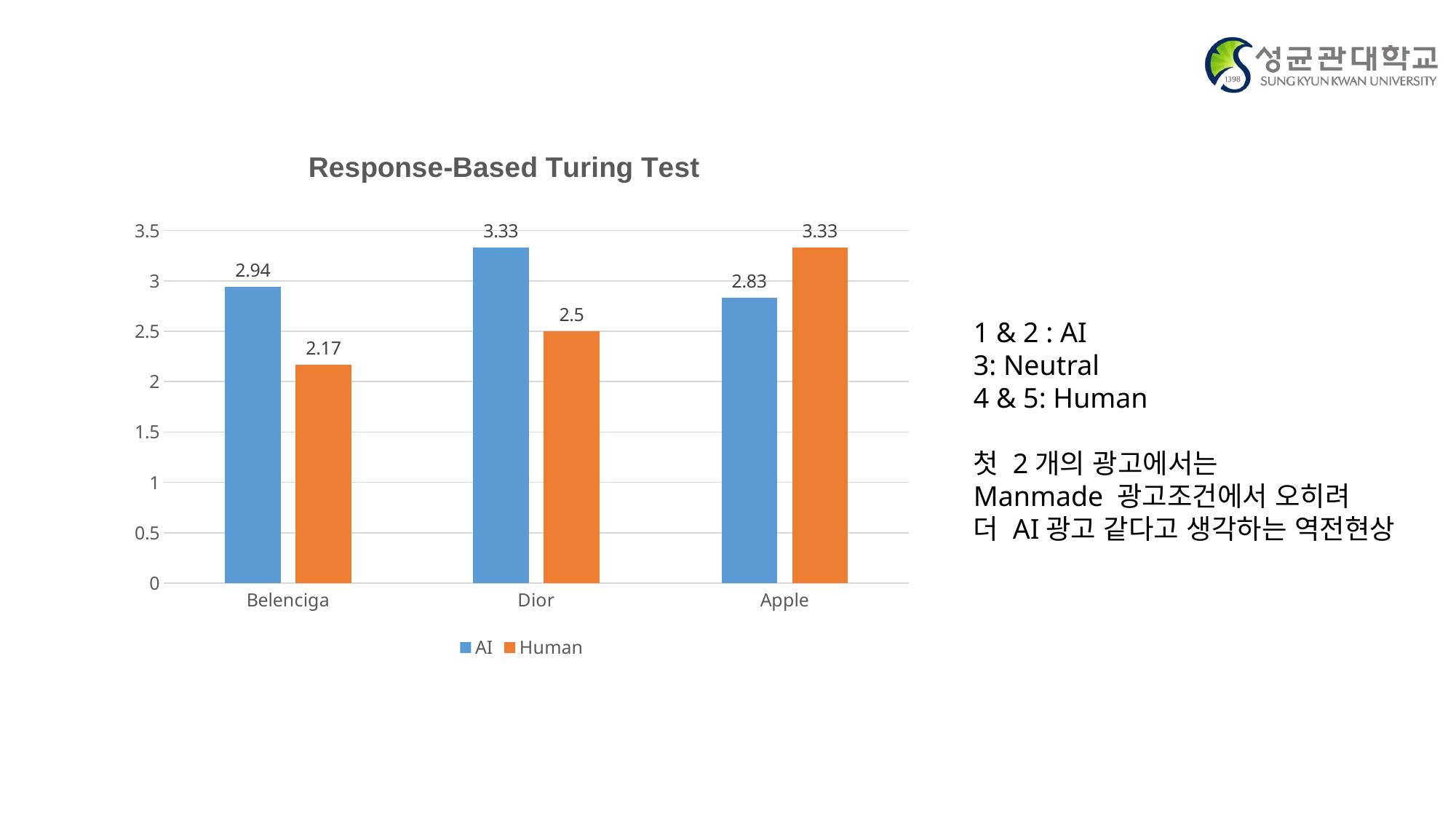
What is the title of the chart? Response-Based Turing Test What kind of chart is shown? Bar chart What is the Human value for Apple? 3.33 How many categories are shown on the x axis? 3 For Dior, which is larger, the AI value or the Human value? AI What is the Human value for Dior? 2.5 What is the AI value for Belenciga? 2.94 Which category has the highest AI value? Dior How many series does the legend list? 2 Which category has the lowest Human value? Belenciga What is the difference between the Human and AI values for Apple? 0.5 What is the difference between the AI and Human values for Belenciga? 0.77